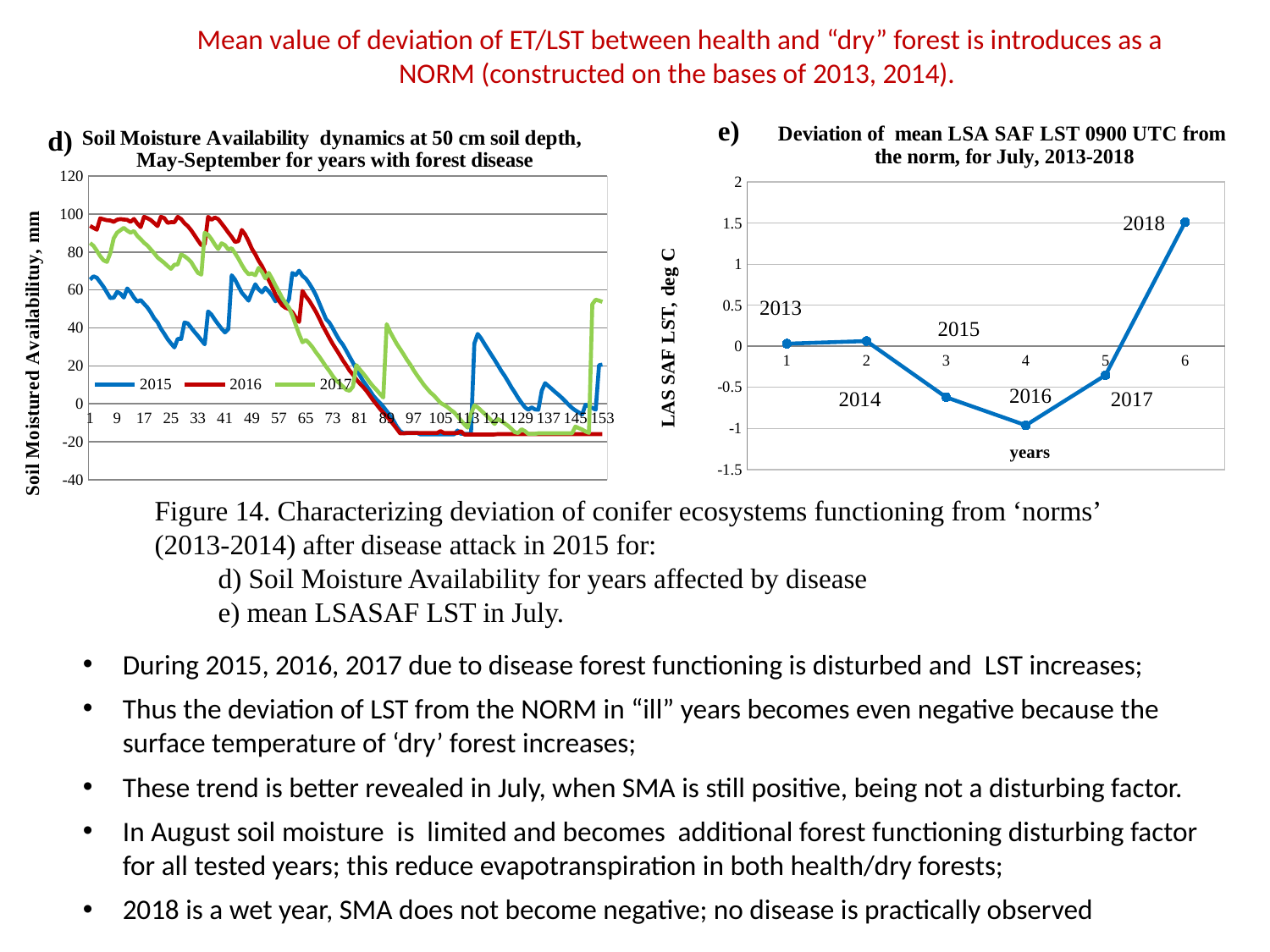
In the chart "Deviation of mean LSA SAF LST 0900 UTC from the norm, for July, 2013-2018", is the value for 2016 greater or less than -0.5? less What kind of chart is the chart titled "Deviation of mean LSA SAF LST 0900 UTC from the norm, for July, 2013-2018"? line chart In the chart "Deviation of mean LSA SAF LST 0900 UTC from the norm, for July, 2013-2018", is the value for 2018 greater or less than 1? greater In the chart "Deviation of mean LSA SAF LST 0900 UTC from the norm, for July, 2013-2018", what is the x-axis title? years In the chart "Deviation of mean LSA SAF LST 0900 UTC from the norm, for July, 2013-2018", which year has the lowest deviation? 2016 In the chart "Deviation of mean LSA SAF LST 0900 UTC from the norm, for July, 2013-2018", which year has the highest deviation? 2018 In the chart "Soil Moisture Availability dynamics at 50 cm soil depth, May-September for years with forest disease", is the value of the 2016 series at x = 1 greater or less than 80? greater What kind of chart is the chart titled "Soil Moisture Availability dynamics at 50 cm soil depth, May-September for years with forest disease"? line chart Which series are listed in the legend of the chart "Soil Moisture Availability dynamics at 50 cm soil depth, May-September for years with forest disease"? 2015, 2016, 2017 In the chart "Deviation of mean LSA SAF LST 0900 UTC from the norm, for July, 2013-2018", which year has the larger value, 2015 or 2017? 2017 How many series does the legend list in the chart "Soil Moisture Availability dynamics at 50 cm soil depth, May-September for years with forest disease"? 3 In the chart "Deviation of mean LSA SAF LST 0900 UTC from the norm, for July, 2013-2018", how many data points are plotted? 6